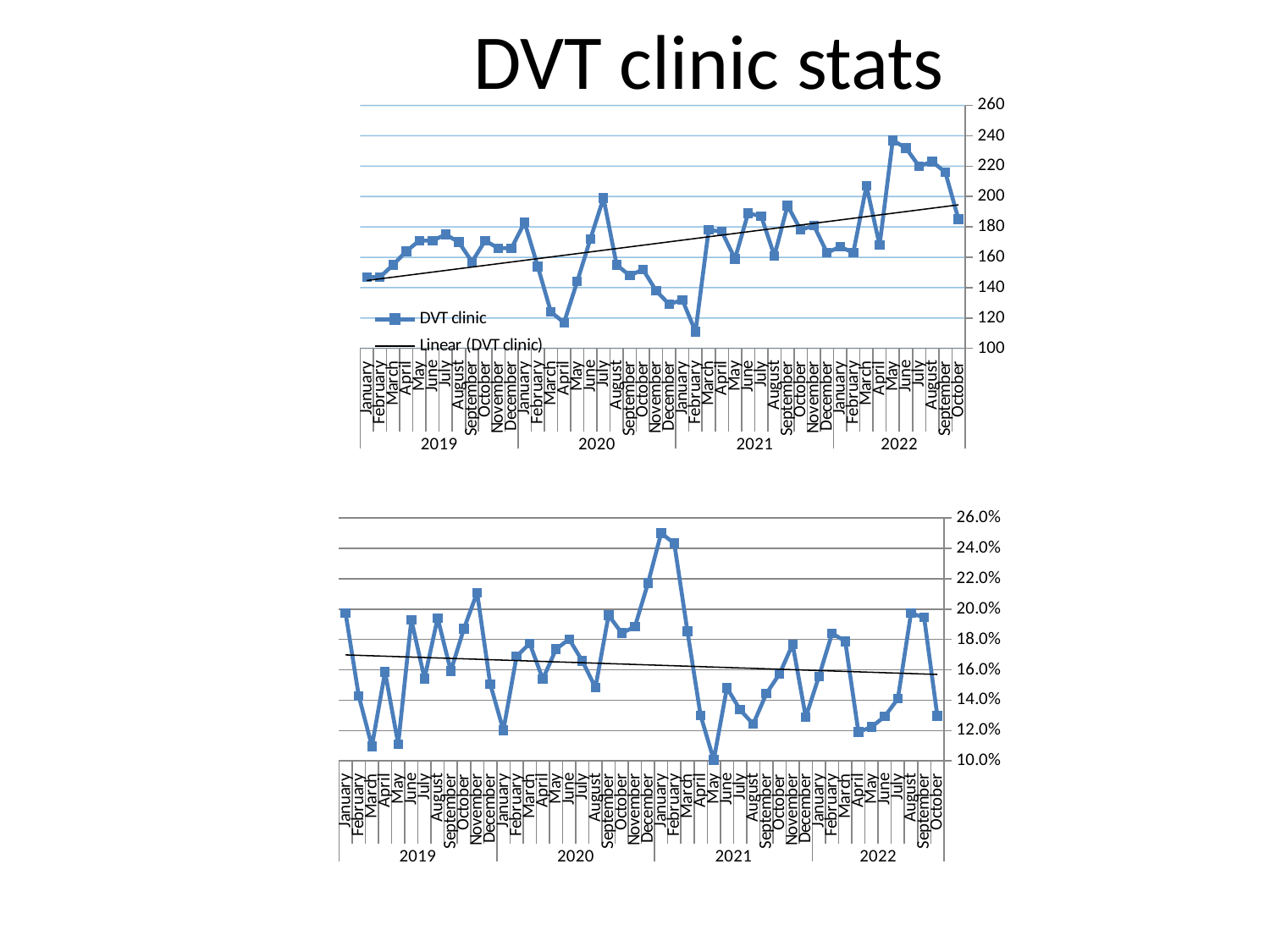
In the top chart, which month has the highest DVT clinic value? May 2022 In the top chart, is the DVT clinic value for May 2022 greater or less than 220? greater In the bottom chart, which month has the lowest percentage value? May 2021 In the top chart, does the linear trendline rise or fall from 2019 to 2022? rise In the top chart, what kind of chart is used to show the DVT clinic data? line chart In the bottom chart, which month has the highest percentage value? January 2021 In the top chart, is the DVT clinic value for February 2021 greater or less than 120? less In the top chart, what are the two legend entries? DVT clinic and Linear (DVT clinic) In the top chart, which is larger, the DVT clinic value for July 2020 or for February 2021? July 2020 In the top chart, which month has the lowest DVT clinic value? February 2021 In the bottom chart, is the value for May 2021 greater or less than 12.0%? less In the top chart, how many entries does the legend list? 2